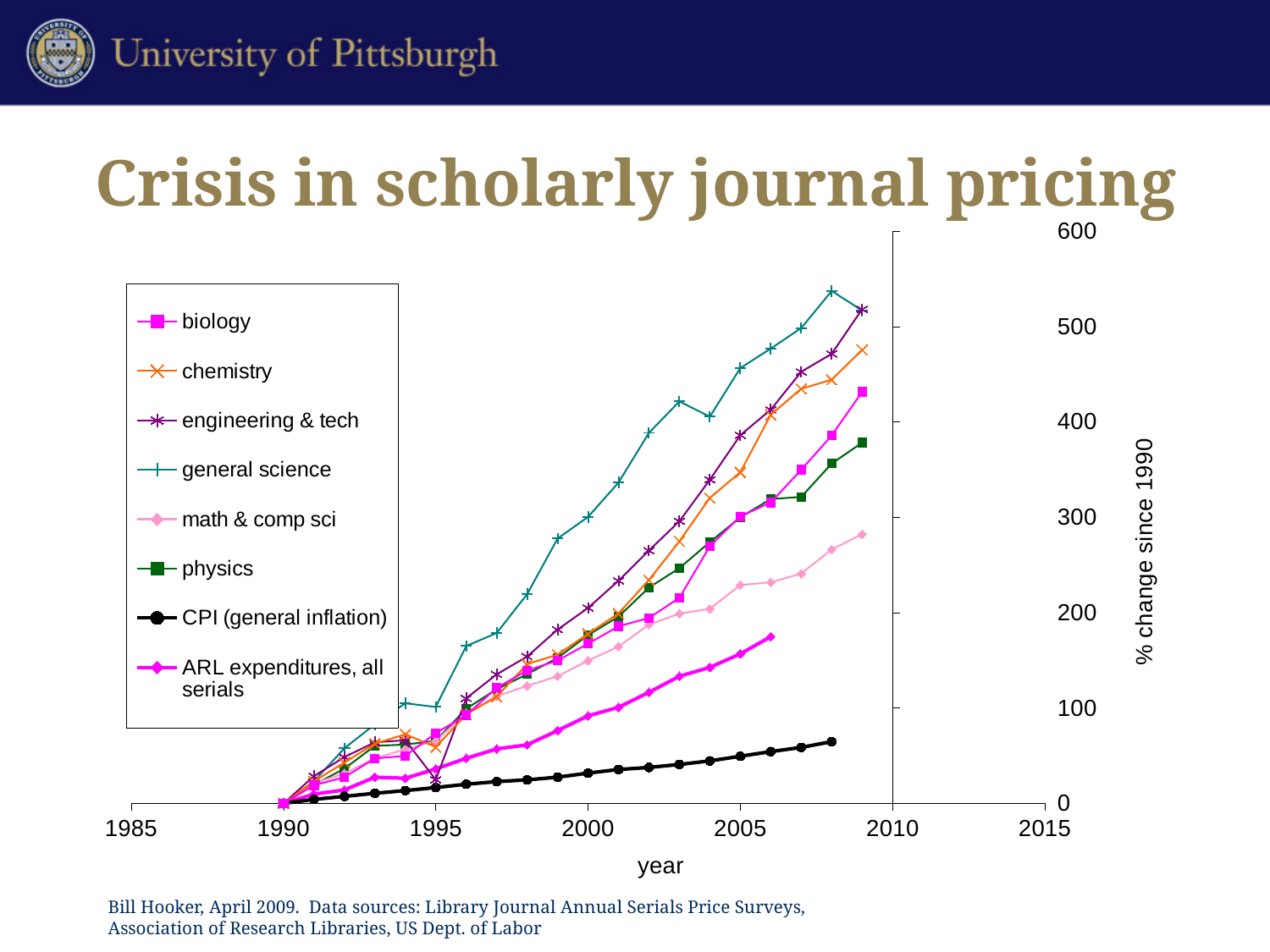
What is the title of the chart? Crisis in scholarly journal pricing Does the CPI (general inflation) series rise or fall from 1990 to 2008? rise Is the value for ARL expenditures, all serials in 2006 greater or less than 100? greater Which series has the lowest values across the chart? CPI (general inflation) What kind of chart is shown on the slide? line chart Is the value for general science in 2008 greater or less than 500? greater Is the value for biology in 2009 greater or less than 400? greater What is the label on the vertical axis? % change since 1990 In 2005, which is larger: general science or biology? general science How many series does the legend list? 8